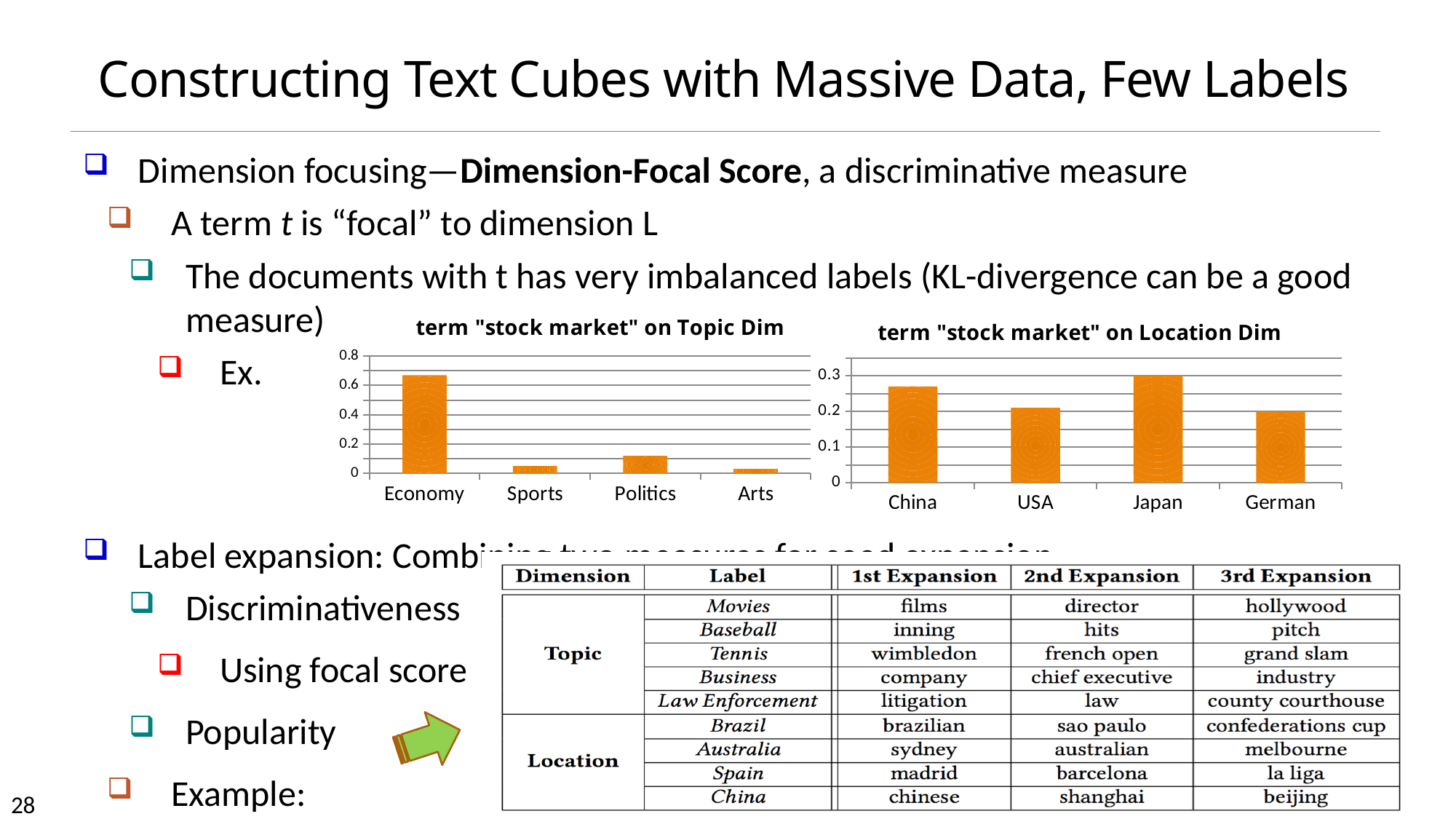
In the "term "stock market" on Location Dim" chart, is the value for USA greater or less than 0.3? less In the "term "stock market" on Topic Dim" chart, which category has the highest value? Economy In the "term "stock market" on Location Dim" chart, which category has the highest value? Japan In the "term "stock market" on Topic Dim" chart, which is larger, Economy or Politics? Economy How many categories are shown in the "term "stock market" on Topic Dim" chart? 4 In the "term "stock market" on Topic Dim" chart, is the value for Politics greater or less than 0.2? less How many categories are shown in the "term "stock market" on Location Dim" chart? 4 What is the title of the chart on the right side of the slide? term "stock market" on Location Dim In the "term "stock market" on Location Dim" chart, is the value for China greater or less than 0.2? greater What kind of chart is the "term "stock market" on Topic Dim" chart? bar chart In the "term "stock market" on Location Dim" chart, which is larger, China or USA? China